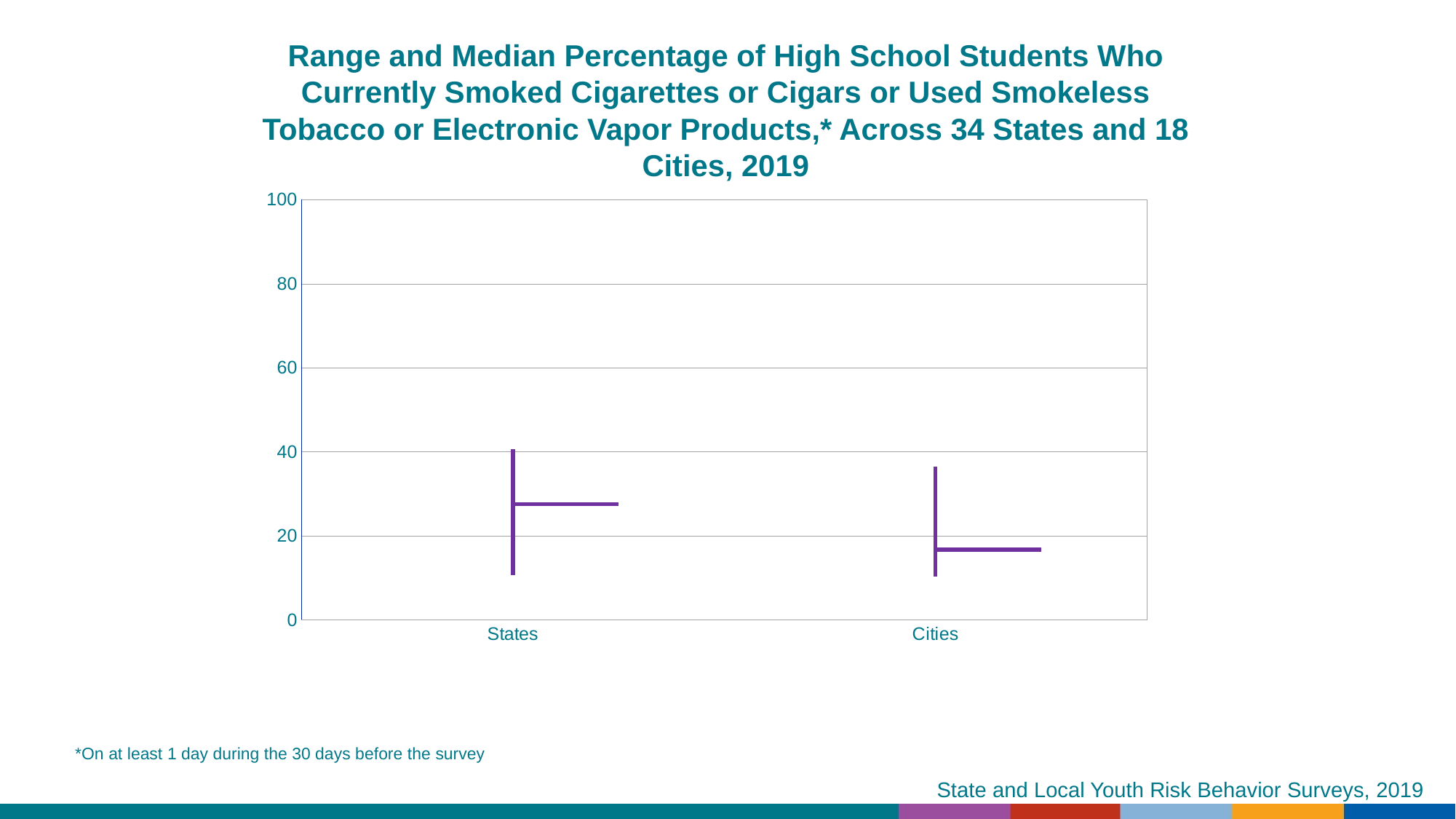
Is the median value for Cities greater or less than 20? less Is the bottom of the range for Cities greater or less than 20? less What is the highest value shown on the y axis of the chart? 100 Which category has the higher median value, States or Cities? States What year does the chart title say the data are from? 2019 How many categories are shown on the x axis of the chart? 2 Is the median value for States greater or less than 20? greater Which category has the higher top of its range, States or Cities? States What are the two categories shown on the x axis? States and Cities